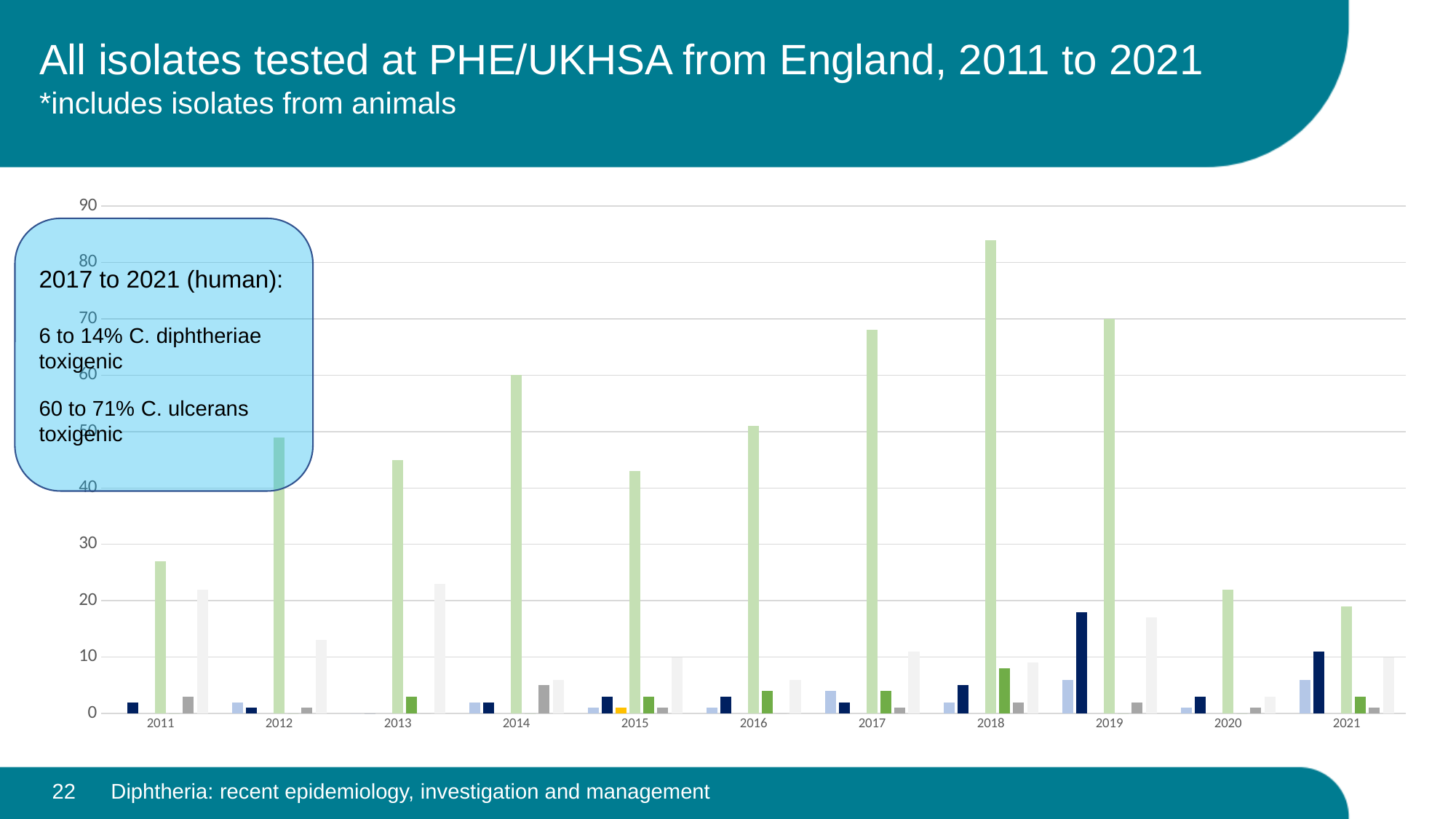
How many years are shown along the x axis of the chart? 11 Which year has a taller tallest bar, 2014 or 2021? 2014 Which year has the tallest bar in the chart? 2018 Is the tallest bar for 2016 greater or less than 60? less Is the tallest bar for 2018 greater or less than 80? greater Is the tallest bar for 2011 greater or less than 30? less What is the title of the slide containing the chart? All isolates tested at PHE/UKHSA from England, 2011 to 2021 What kind of chart is shown on the slide? bar chart Which year has a taller tallest bar, 2018 or 2011? 2018